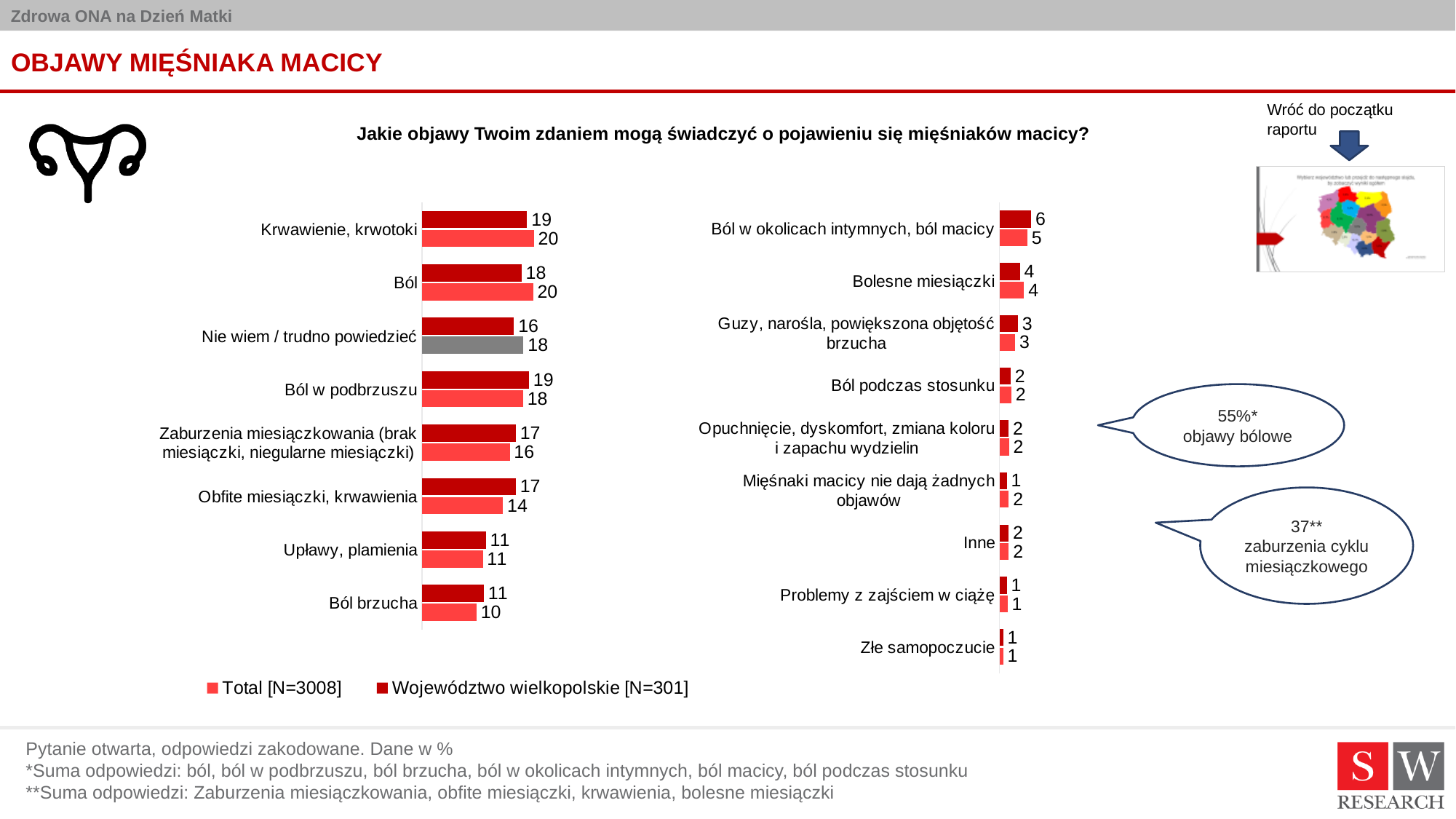
In the right chart, what is the Województwo wielkopolskie [N=301] value for Ból w okolicach intymnych, ból macicy? 6 What type of chart is used on this slide? Bar chart In the left chart, which category has the lowest Total [N=3008] value? Ból brzucha What is the sample size of the Total series shown in the legend? N=3008 In the left chart, what is the Total [N=3008] value for Krwawienie, krwotoki? 20 In the left chart, what is the difference between the Total [N=3008] and Województwo wielkopolskie [N=301] values for Obfite miesiączki, krwawienia? 3 In the left chart, which is larger for Ból: the Total [N=3008] value or the Województwo wielkopolskie [N=301] value? Total [N=3008] In the right chart, which category has the highest Total [N=3008] value? Ból w okolicach intymnych, ból macicy How many categories does the left chart show? 8 How many series does the legend list? 2 How many categories does the right chart show? 9 In the left chart, what is the Województwo wielkopolskie [N=301] value for Obfite miesiączki, krwawienia? 17